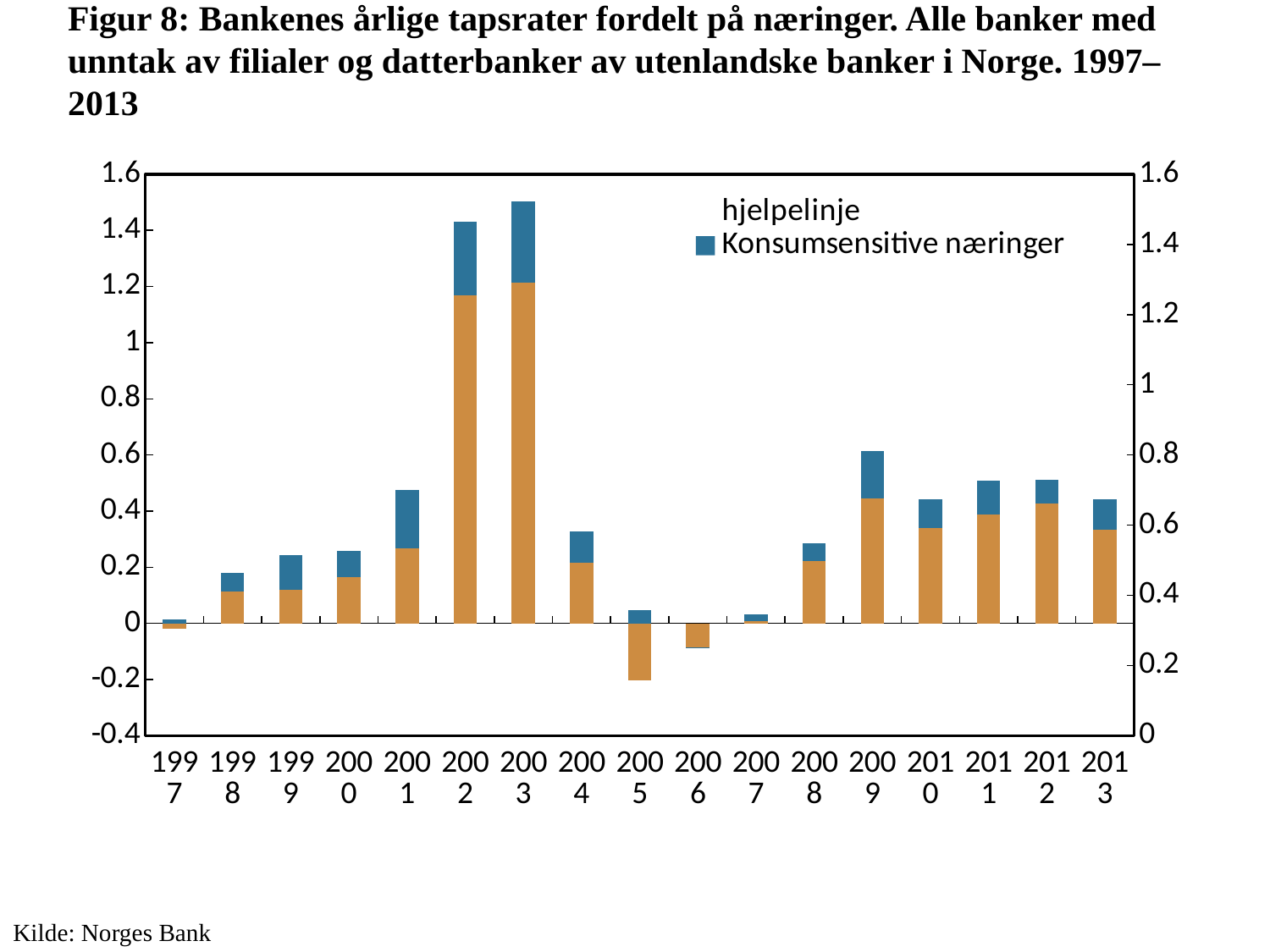
How many series does the legend list? 2 Is the total stacked value for 2001 greater or less than 0.4? greater Is the total stacked value for 1998 greater or less than 0.2? less Is the total stacked bar for 2009 or for 2013 larger? 2009 Which year has the tallest stacked bar? 2003 Is the total stacked value for 2002 greater or less than 1.2? greater Which series is shown in blue according to the legend? Konsumsensitive næringer Which year has the bar that extends furthest below zero? 2005 How many years are shown on the x axis of the chart? 17 Do the stacked bar totals rise or fall from 1997 to 2003? rise What kind of chart is shown on the slide? Stacked bar chart Is the total stacked bar for 2002 or for 2009 larger? 2002